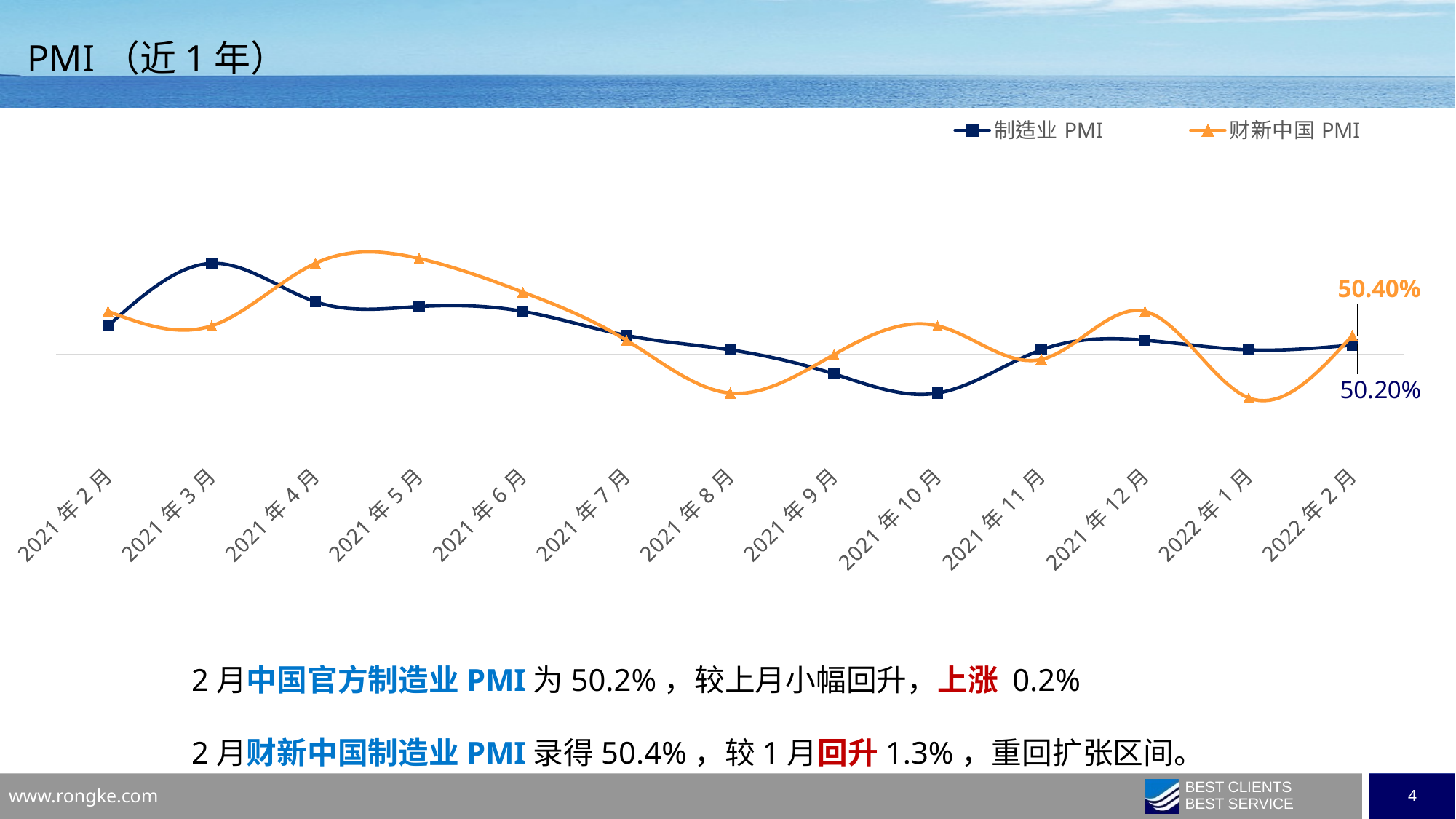
In 2021年3月, which series is higher, 制造业 PMI or 财新中国 PMI? 制造业 PMI Which series is drawn in orange with triangle markers? 财新中国 PMI In which month does 制造业 PMI reach its highest point? 2021年3月 What is the value of 财新中国 PMI for 2022年2月? 50.40% What is the value of 制造业 PMI for 2022年2月? 50.20% How many months are plotted along the x axis? 13 Does 制造业 PMI rise or fall from 2021年3月 to 2021年10月? fall In which month does 制造业 PMI reach its lowest point? 2021年10月 What is the difference between 财新中国 PMI and 制造业 PMI in 2022年2月? 0.20% How many series does the legend list? 2 What type of chart is shown on the slide? line chart In 2021年10月, which series is higher, 制造业 PMI or 财新中国 PMI? 财新中国 PMI